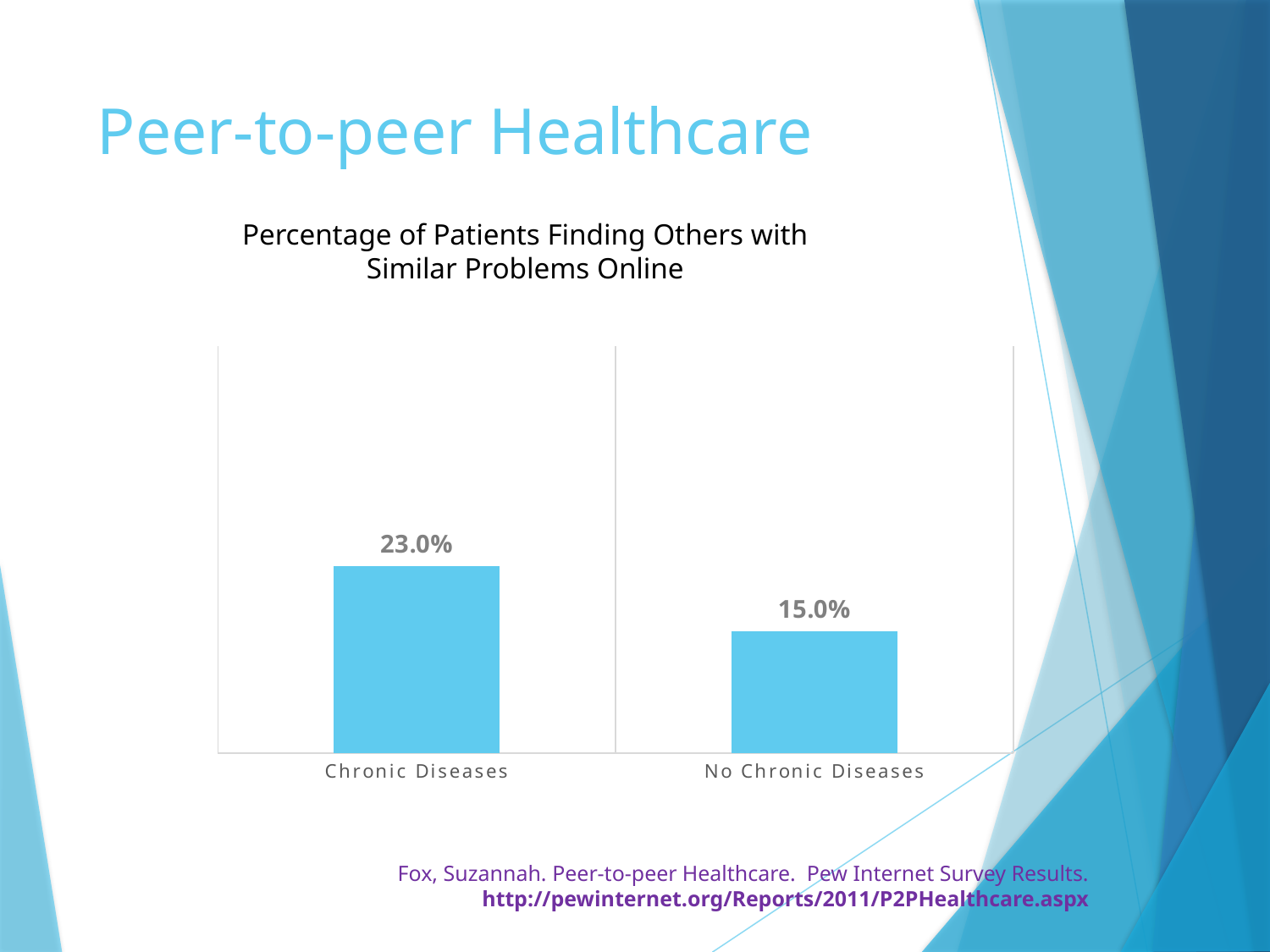
What kind of chart is shown on the slide? Bar chart What is the value for No Chronic Diseases? 15.0% What is the value for Chronic Diseases? 23.0% Which category has the highest value? Chronic Diseases What is the title of the chart? Percentage of Patients Finding Others with Similar Problems Online What is the difference between the values for Chronic Diseases and No Chronic Diseases? 8.0% Which category has the lowest value? No Chronic Diseases Which is larger, the value for Chronic Diseases or the value for No Chronic Diseases? Chronic Diseases How many categories are shown in the chart? 2 What colour are the bars in the chart? Light blue